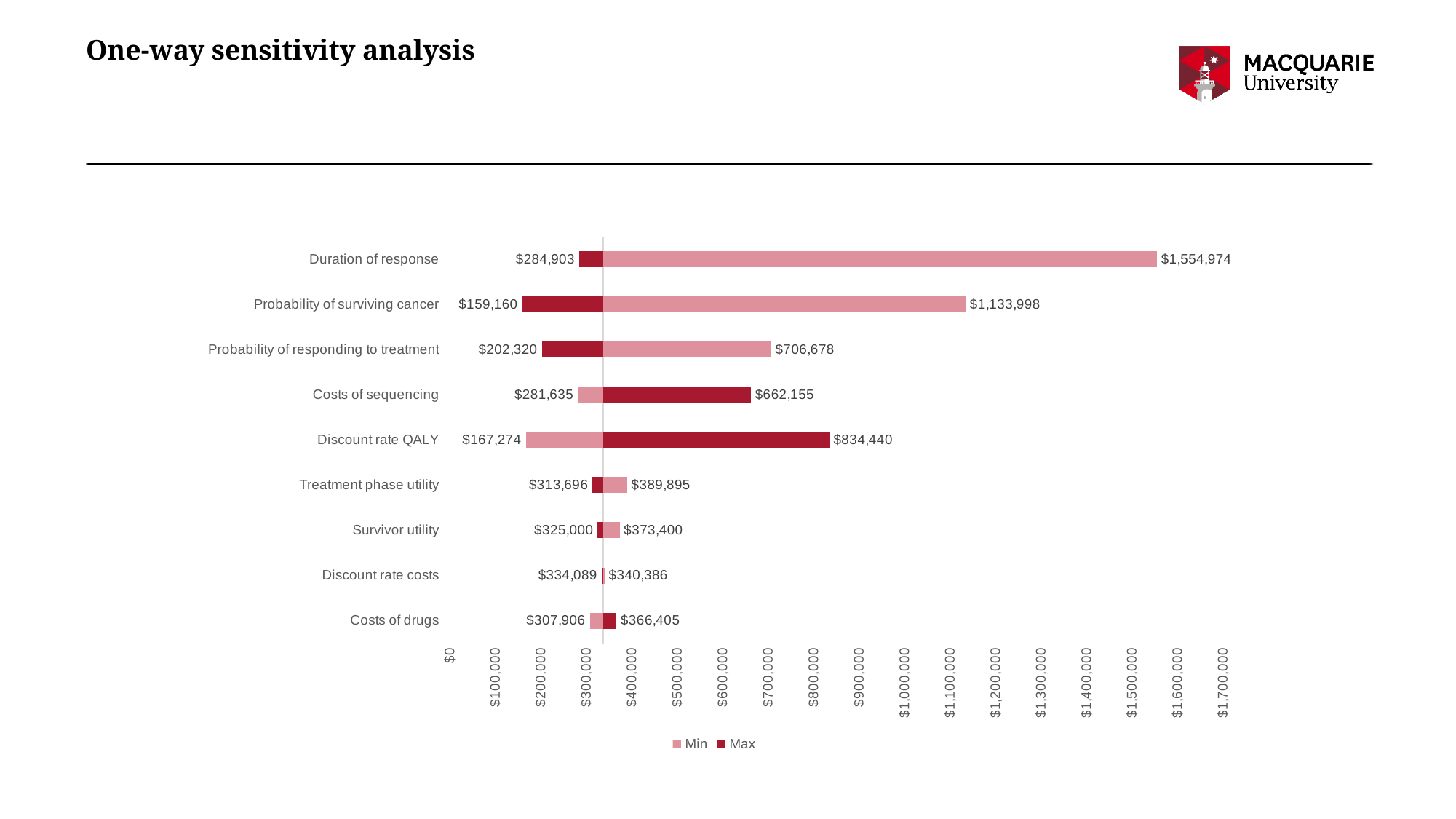
How many series does the legend list? 2 How many categories are plotted on the chart? 9 Which category has the largest right-hand value? Duration of response What is the difference between the higher and lower values for Duration of response? $1,270,071 What kind of chart is shown on the slide? Bar chart What is the higher (right-hand) value shown for Duration of response? $1,554,974 Which category has the smallest left-hand value? Probability of surviving cancer What is the lower (left-hand) value shown for Costs of drugs? $307,906 What is the difference between the higher and lower values for Discount rate costs? $6,297 What is the higher (right-hand) value shown for Discount rate QALY? $834,440 Which has the larger right-hand value: Probability of responding to treatment or Costs of sequencing? Probability of responding to treatment What is the lower (left-hand) value shown for Probability of surviving cancer? $159,160